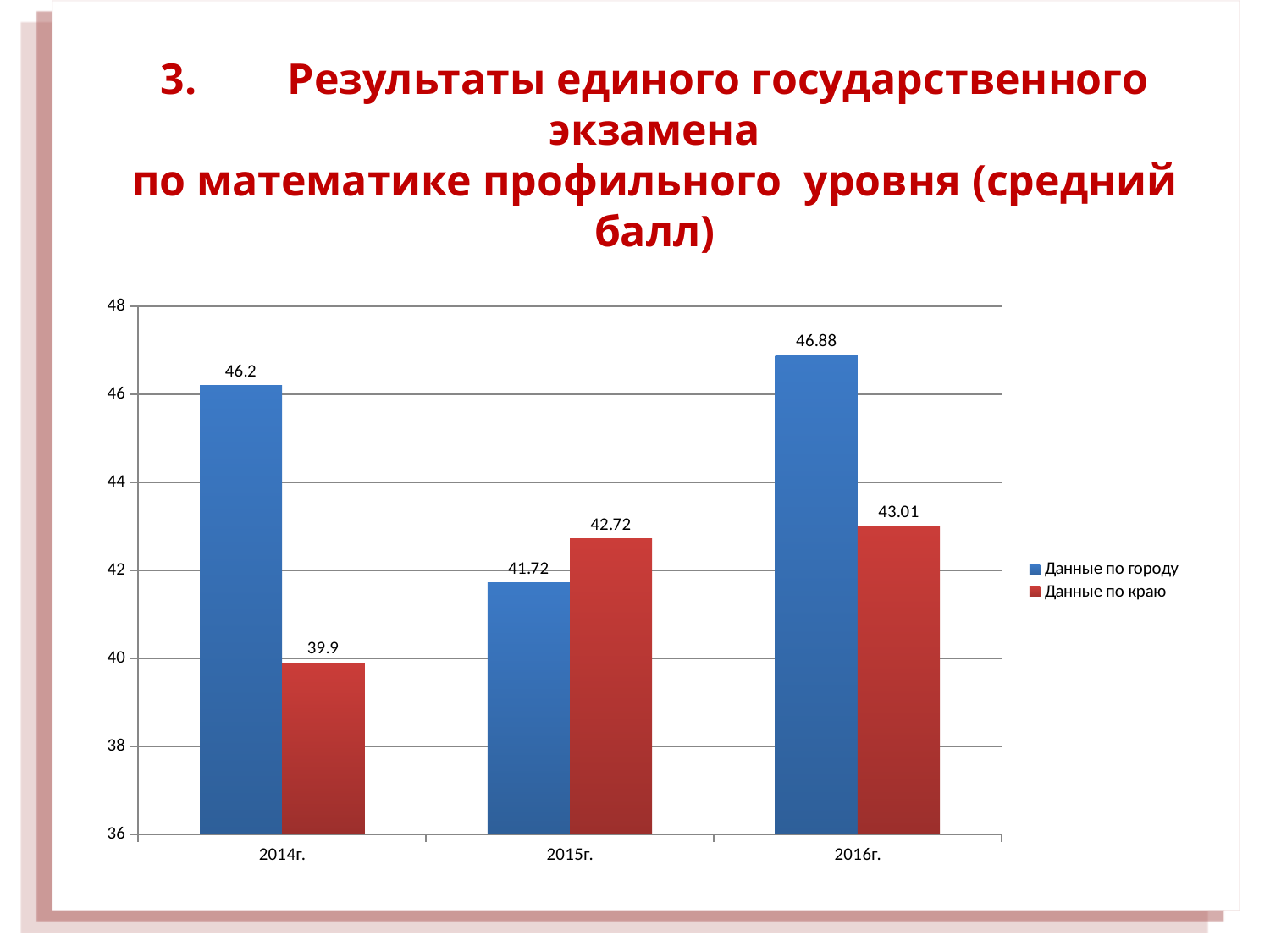
In which year is the value for Данные по краю the lowest? 2014г. Does the value for Данные по краю rise or fall from 2014г. to 2016г.? Rise What is the value for Данные по городу in 2014г.? 46.2 How many years are shown on the x axis? 3 What is the difference between Данные по городу and Данные по краю in 2014г.? 6.3 Which is larger in 2015г., Данные по городу or Данные по краю? Данные по краю What is the value for Данные по городу in 2016г.? 46.88 What is the value for Данные по краю in 2014г.? 39.9 What is the value for Данные по краю in 2015г.? 42.72 What kind of chart is shown on the slide? Bar chart How many series does the legend list? 2 In which year is the value for Данные по городу the highest? 2016г.